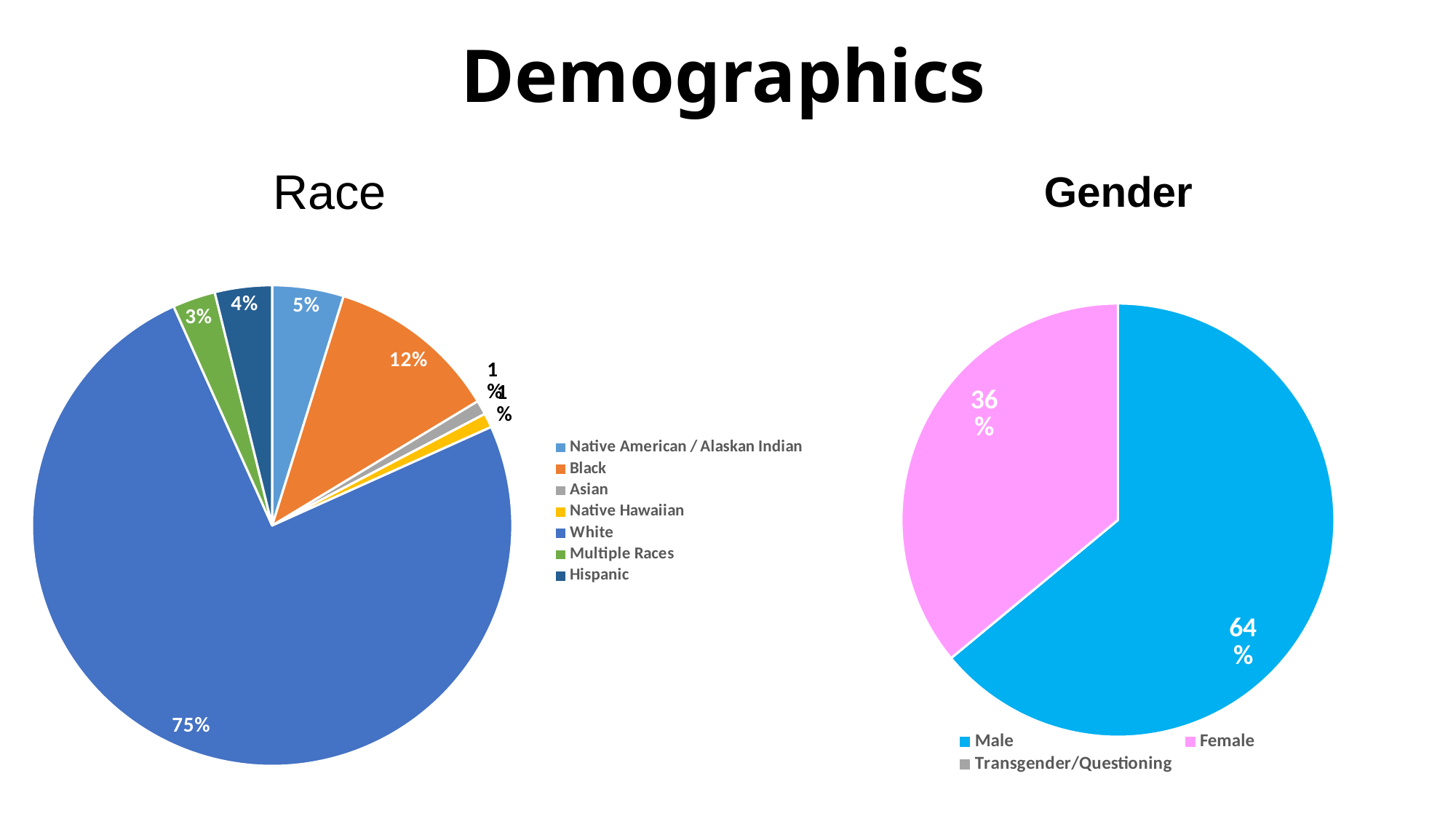
In the Race chart, what percentage is shown for Black? 12% How many categories does the legend of the Race chart list? 7 In the Race chart, what percentage is shown for Multiple Races? 3% In the Race chart, what percentage is shown for Hispanic? 4% In the Race chart, which category has the largest slice? White In the Race chart, what share of the pie is White? 75% What type of chart is the Gender chart? Pie chart In the Race chart, which is larger, Hispanic or Multiple Races? Hispanic In the Gender chart, what percentage is shown for Male? 64% In the Race chart, what is the difference between the Black and Native American / Alaskan Indian percentages? 7% In the Gender chart, what share of the pie is Female? 36% In the Gender chart, what is the difference between the Male and Female percentages? 28%